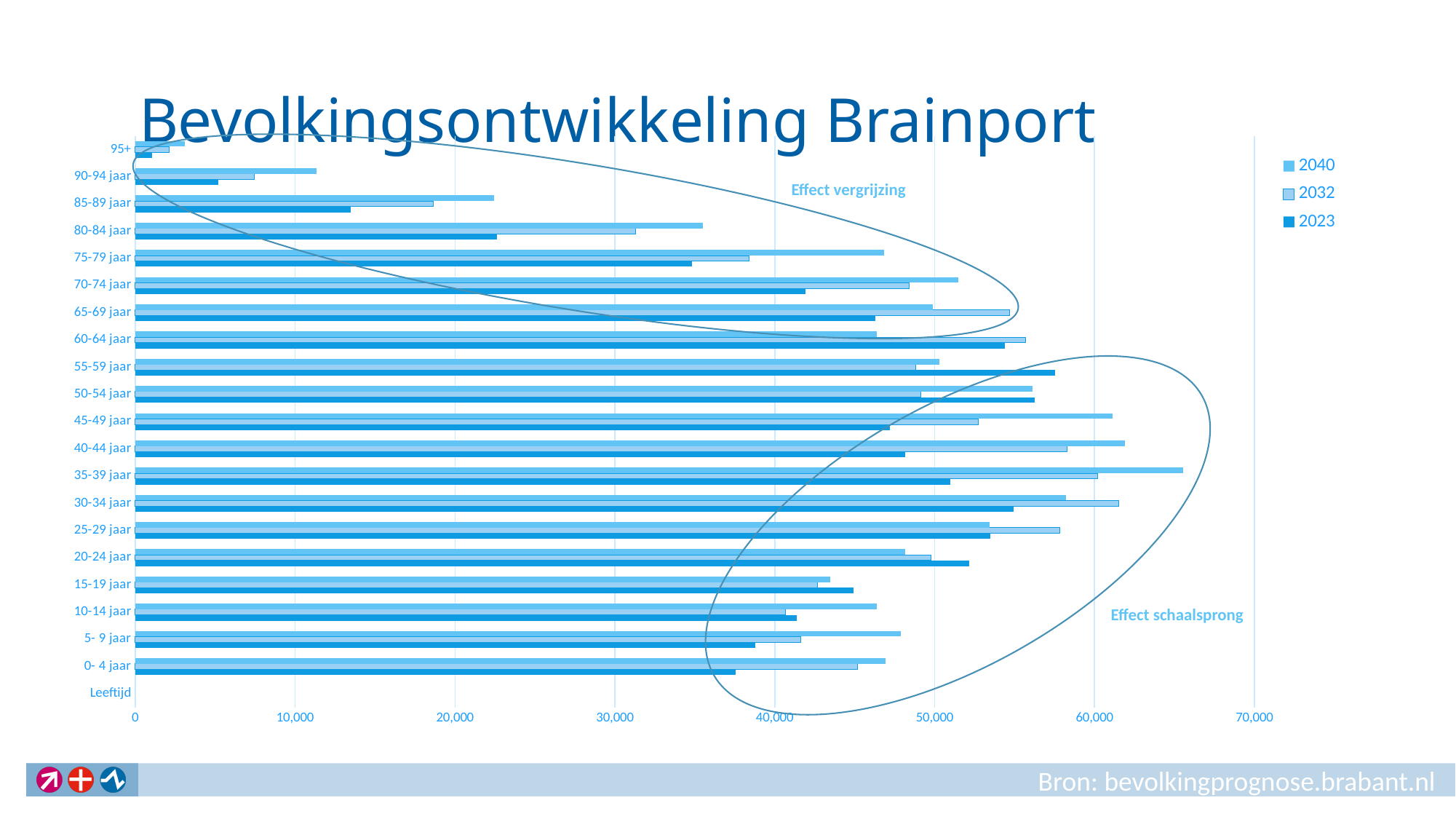
What kind of chart is shown on the slide? bar chart Which age group has the lowest value for the 2040 series? 95+ How many series does the legend list? 3 Is the 2023 value for 15-19 jaar greater or less than 40,000? greater Is the 2040 value for 80-84 jaar greater or less than 40,000? less What is the title of the chart? Bevolkingsontwikkeling Brainport For 55-59 jaar, which series has the larger value, 2023 or 2040? 2023 Is the 2023 value for 0- 4 jaar greater or less than 40,000? less Which series are listed in the legend? 2040, 2032, 2023 Which age group has the highest value for the 2040 series? 35-39 jaar For 85-89 jaar, which series has the larger value, 2040 or 2023? 2040